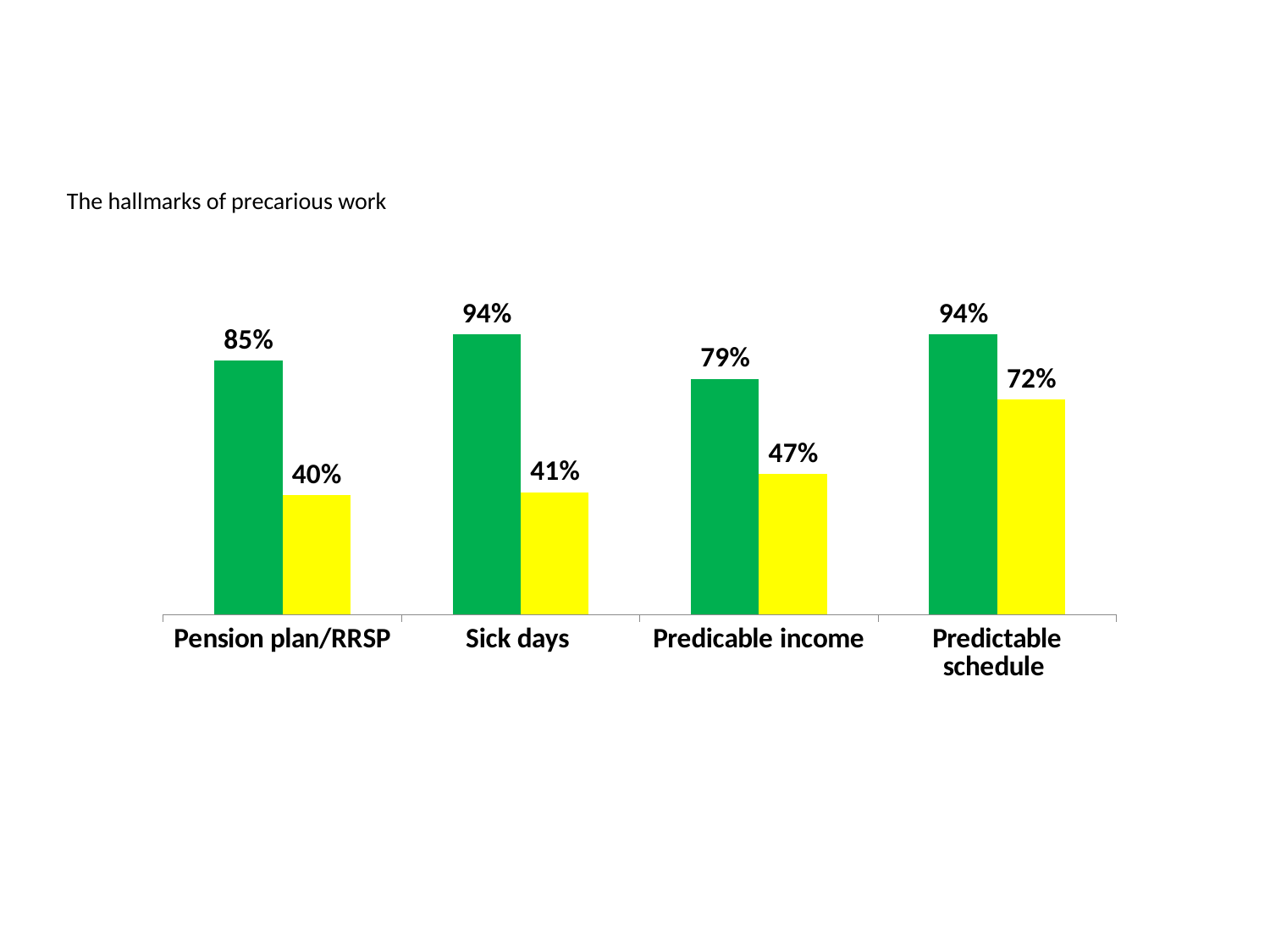
Which is larger: the yellow bar for Predicable income or the yellow bar for Sick days? Predicable income What is the difference between the green and yellow bars for Pension plan/RRSP? 45% How many categories are shown on the x axis? 4 What is the value of the yellow bar for Sick days? 41% What is the value of the yellow bar for Predictable schedule? 72% What is the difference between the green and yellow bars for Predictable schedule? 22% Which category has the lowest yellow bar value? Pension plan/RRSP Which category has the lowest green bar value? Predicable income What is the value of the green bar for Pension plan/RRSP? 85% What is the value of the green bar for Predicable income? 79% What type of chart is shown on the slide? Bar chart Which category has the highest yellow bar value? Predictable schedule